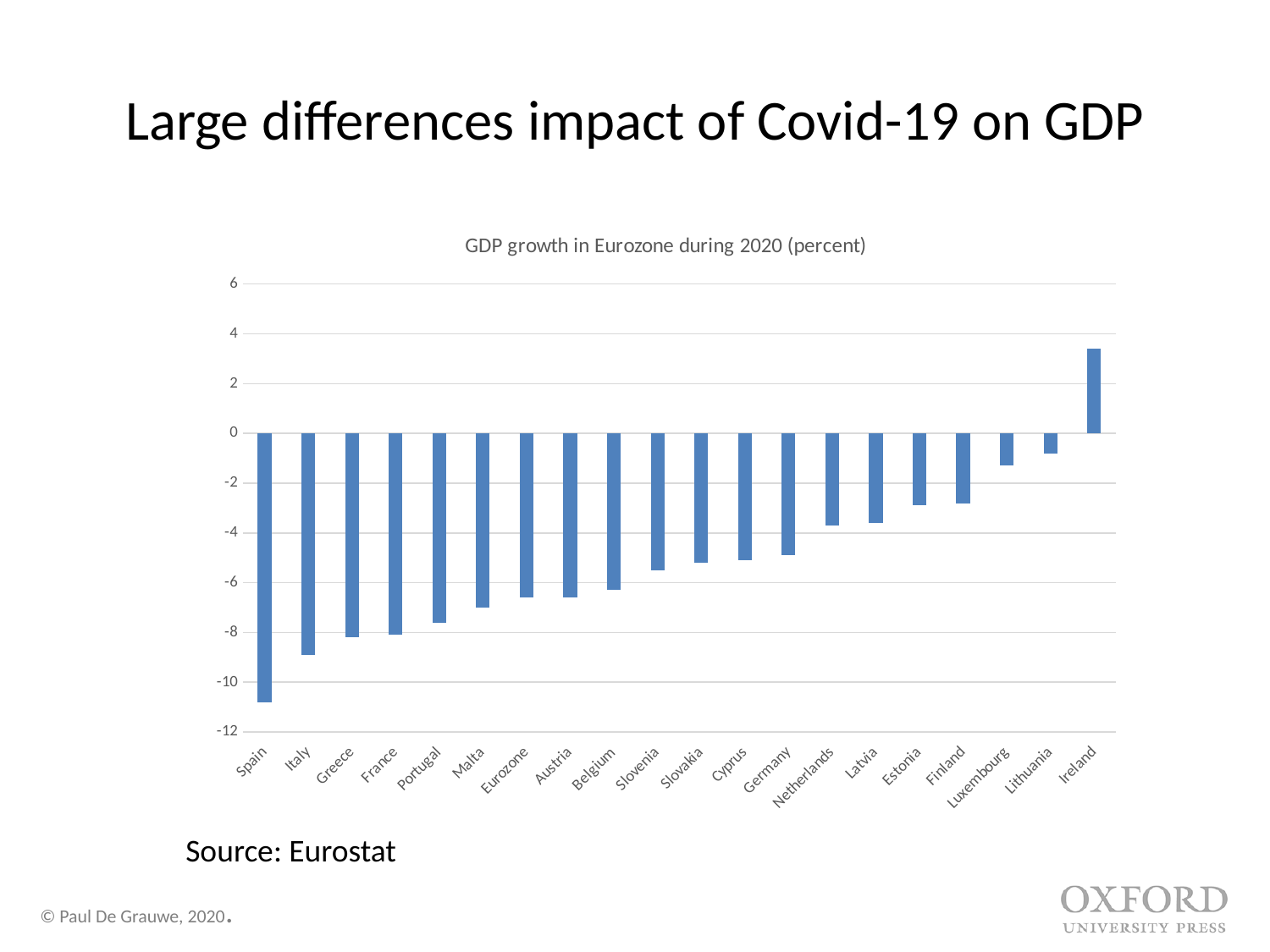
Is the value for Germany greater or less than -6? greater Which has the larger (less negative) GDP growth, Belgium or Slovenia? Slovenia What is the title of the chart? GDP growth in Eurozone during 2020 (percent) Is the value for Spain greater or less than -10? less Do the values generally rise or fall moving from left to right along the x axis? Rise Is the value for Ireland greater or less than 2? greater How many categories are plotted on the x axis of the chart? 20 What kind of chart is shown on the slide? Bar chart Which category has the lowest GDP growth in the chart? Spain Which category has the highest GDP growth in the chart? Ireland